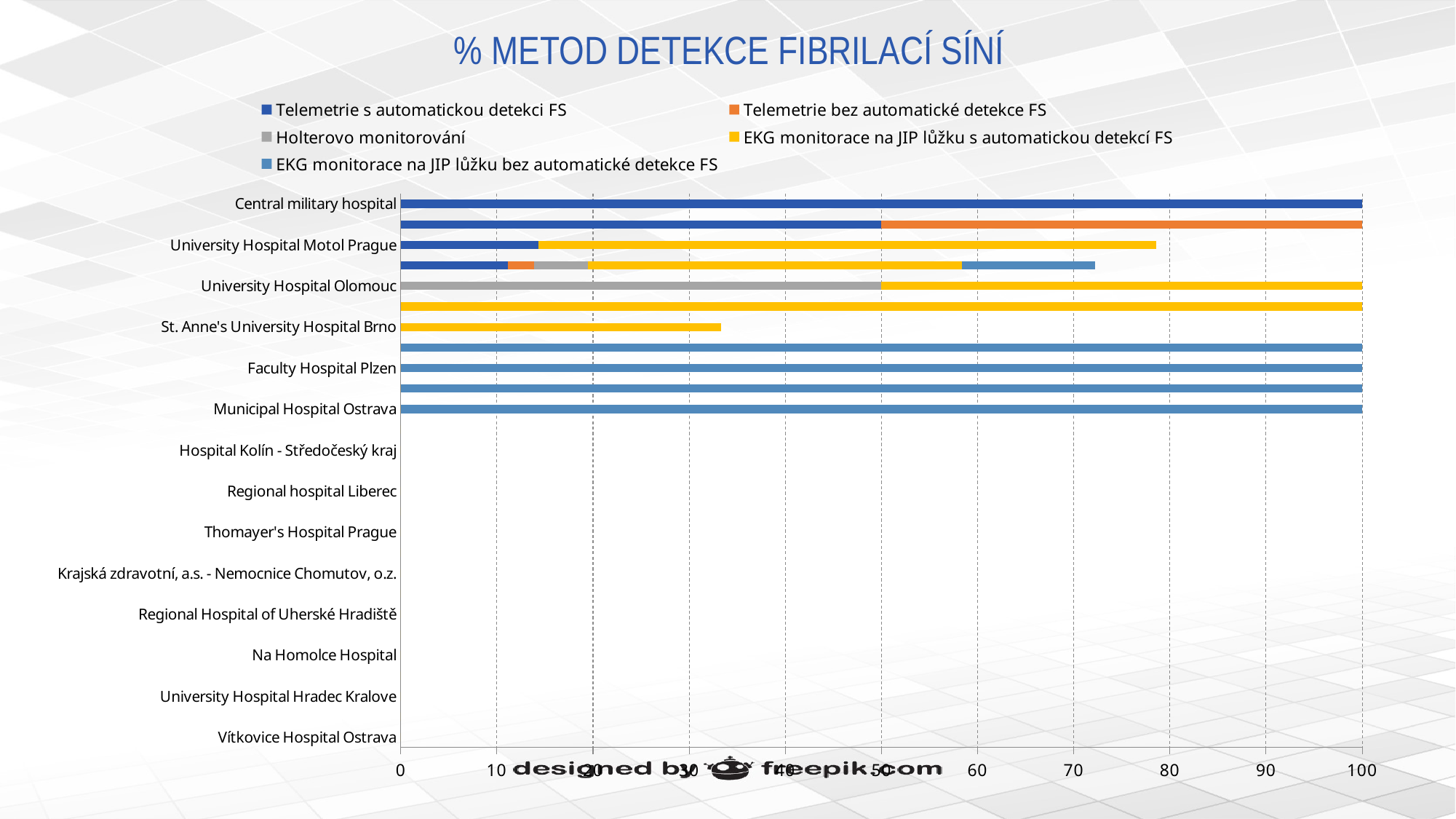
Which legend entry is shown in orange? Telemetrie bez automatické detekce FS How many series does the legend list? 5 Is the value of Telemetrie s automatickou detekci FS for University Hospital Motol Prague greater or less than 20? less Which has the larger value for Telemetrie s automatickou detekci FS: Central military hospital or University Hospital Motol Prague? Central military hospital What is the value of EKG monitorace na JIP lůžku bez automatické detekce FS for Faculty Hospital Plzen? 100 What is the total of the stacked bar for University Hospital Olomouc? 100 What is the value of EKG monitorace na JIP lůžku bez automatické detekce FS for Municipal Hospital Ostrava? 100 What type of chart is shown on the slide? Bar chart Is the value of EKG monitorace na JIP lůžku s automatickou detekcí FS for St. Anne's University Hospital Brno greater or less than 40? less What is the title of the chart? % METOD DETEKCE FIBRILACÍ SÍNÍ What is the value of Holterovo monitorování for University Hospital Olomouc? 50 What is the value of Telemetrie s automatickou detekci FS for Central military hospital? 100